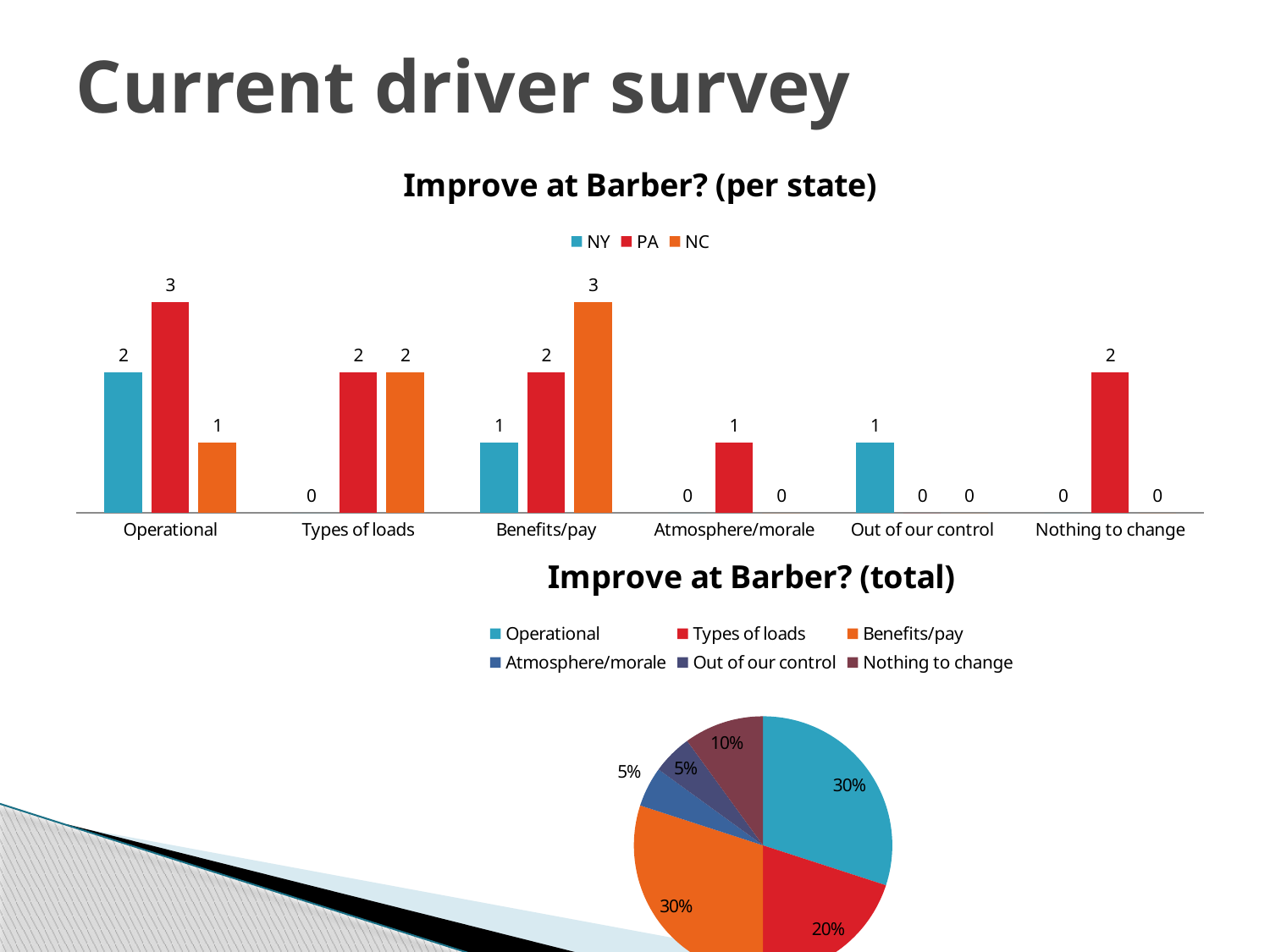
How many categories are shown on the x axis of the 'Improve at Barber? (per state)' chart? 6 In the 'Improve at Barber? (per state)' chart, what is the value for NC in the Benefits/pay category? 3 What kind of chart is 'Improve at Barber? (total)'? Pie chart In the 'Improve at Barber? (per state)' chart, which is larger in the Benefits/pay category: NY or NC? NC In the 'Improve at Barber? (per state)' chart, what is the value for PA in the Operational category? 3 What kind of chart is 'Improve at Barber? (per state)'? Bar chart In the 'Improve at Barber? (per state)' chart, what is the value for NY in the Out of our control category? 1 In the 'Improve at Barber? (per state)' chart, what is the difference between the PA and NC values in the Operational category? 2 How many series does the legend of the 'Improve at Barber? (per state)' chart list? 3 In the 'Improve at Barber? (total)' pie chart, what share does Nothing to change have? 10% In the 'Improve at Barber? (total)' pie chart, what share does Types of loads have? 20% In the 'Improve at Barber? (per state)' chart, which state has the highest value in the Operational category? PA